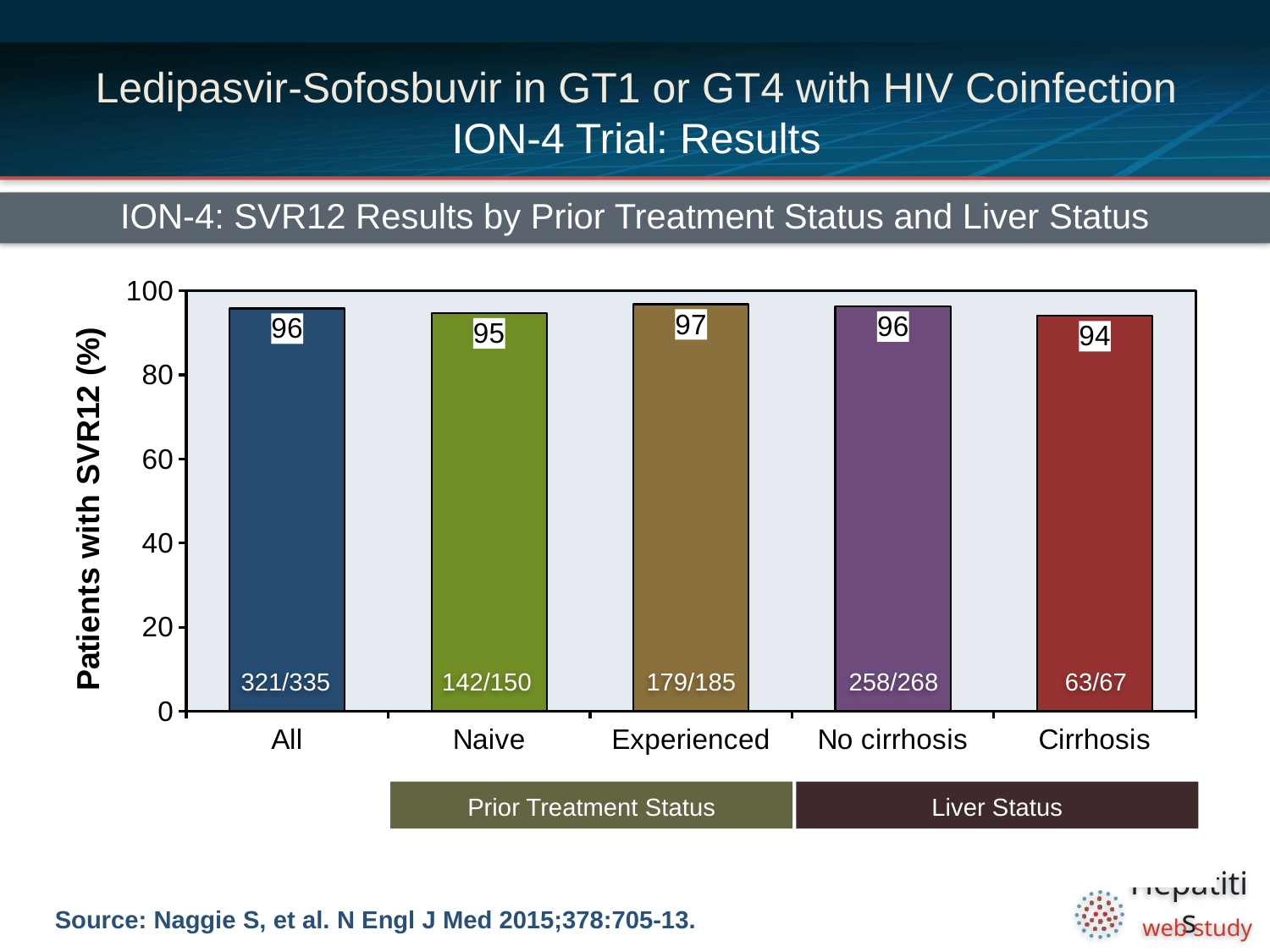
What fraction of patients is shown for the Naive group? 142/150 How many groups are shown on the x axis? 5 What kind of chart is shown on the slide? Bar chart Which group has the lowest SVR12 rate? Cirrhosis Which has a higher SVR12 rate, Naive or Experienced? Experienced Which group has the highest SVR12 rate? Experienced What fraction of patients is shown for the No cirrhosis group? 258/268 What is the label of the y axis? Patients with SVR12 (%) What is the SVR12 rate for the Experienced group? 97 What is the SVR12 rate for the Cirrhosis group? 94 What is the SVR12 rate for the All group? 96 What is the difference in SVR12 rate between the Experienced and Cirrhosis groups? 3